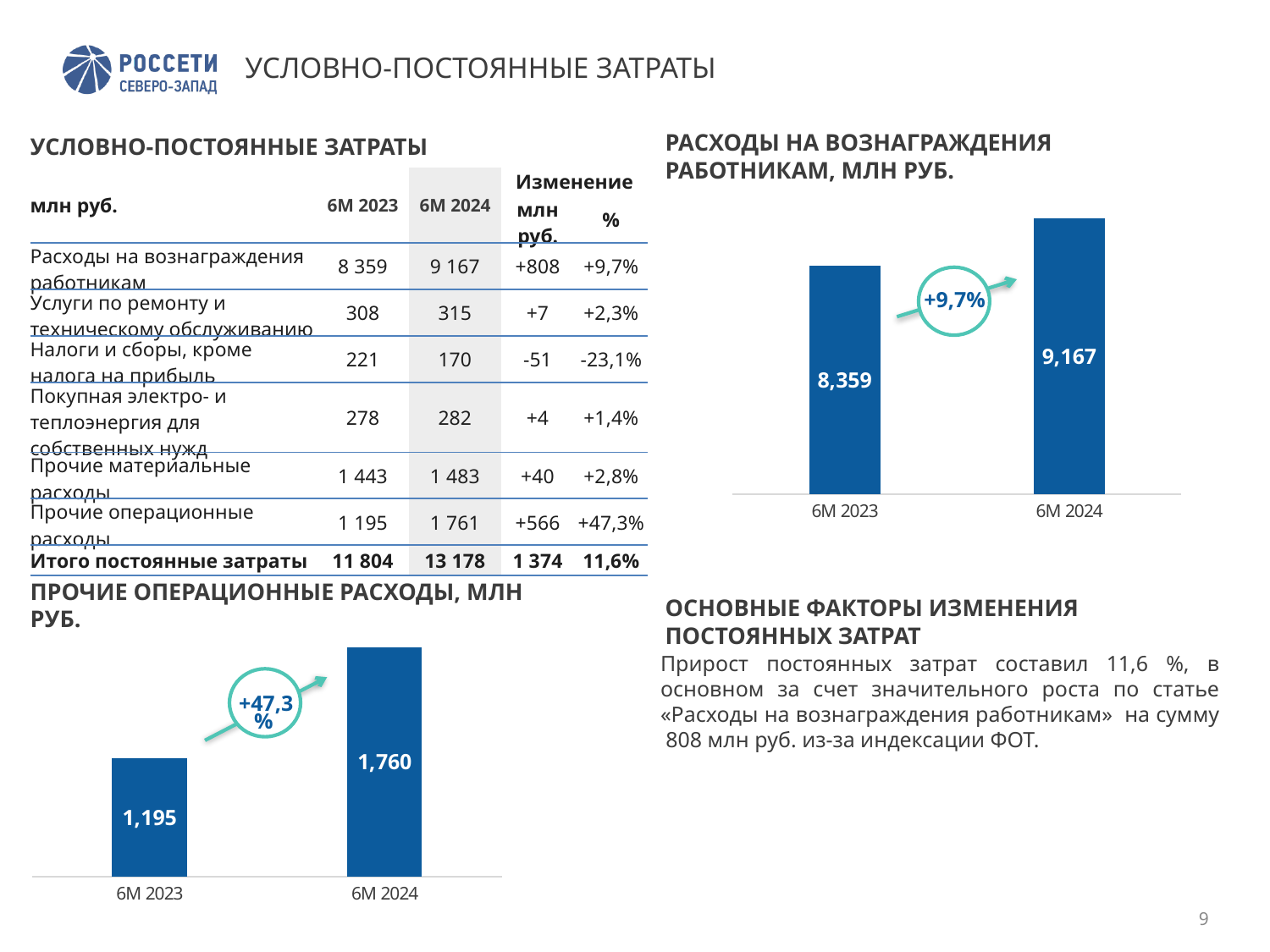
In the chart titled 'РАСХОДЫ НА ВОЗНАГРАЖДЕНИЯ РАБОТНИКАМ, МЛН РУБ.', what is the value for 6M 2023? 8,359 In the chart titled 'ПРОЧИЕ ОПЕРАЦИОННЫЕ РАСХОДЫ, МЛН РУБ.', what is the value for 6M 2023? 1,195 In the chart titled 'РАСХОДЫ НА ВОЗНАГРАЖДЕНИЯ РАБОТНИКАМ, МЛН РУБ.', what is the value for 6M 2024? 9,167 In the chart titled 'ПРОЧИЕ ОПЕРАЦИОННЫЕ РАСХОДЫ, МЛН РУБ.', what is the difference between the 6M 2024 and 6M 2023 values? 565 In the chart titled 'РАСХОДЫ НА ВОЗНАГРАЖДЕНИЯ РАБОТНИКАМ, МЛН РУБ.', which period has the higher value? 6M 2024 What kind of chart is the one titled 'ПРОЧИЕ ОПЕРАЦИОННЫЕ РАСХОДЫ, МЛН РУБ.'? bar chart In the chart titled 'ПРОЧИЕ ОПЕРАЦИОННЫЕ РАСХОДЫ, МЛН РУБ.', what is the value for 6M 2024? 1,760 In the chart titled 'ПРОЧИЕ ОПЕРАЦИОННЫЕ РАСХОДЫ, МЛН РУБ.', do the values rise or fall from 6M 2023 to 6M 2024? rise In the chart titled 'РАСХОДЫ НА ВОЗНАГРАЖДЕНИЯ РАБОТНИКАМ, МЛН РУБ.', what is the difference between the 6M 2024 and 6M 2023 values? 808 In the chart titled 'ПРОЧИЕ ОПЕРАЦИОННЫЕ РАСХОДЫ, МЛН РУБ.', which period has the lower value? 6M 2023 In the chart titled 'РАСХОДЫ НА ВОЗНАГРАЖДЕНИЯ РАБОТНИКАМ, МЛН РУБ.', what percentage change is shown between the two bars? +9,7% How many bars are shown in the chart titled 'РАСХОДЫ НА ВОЗНАГРАЖДЕНИЯ РАБОТНИКАМ, МЛН РУБ.'? 2